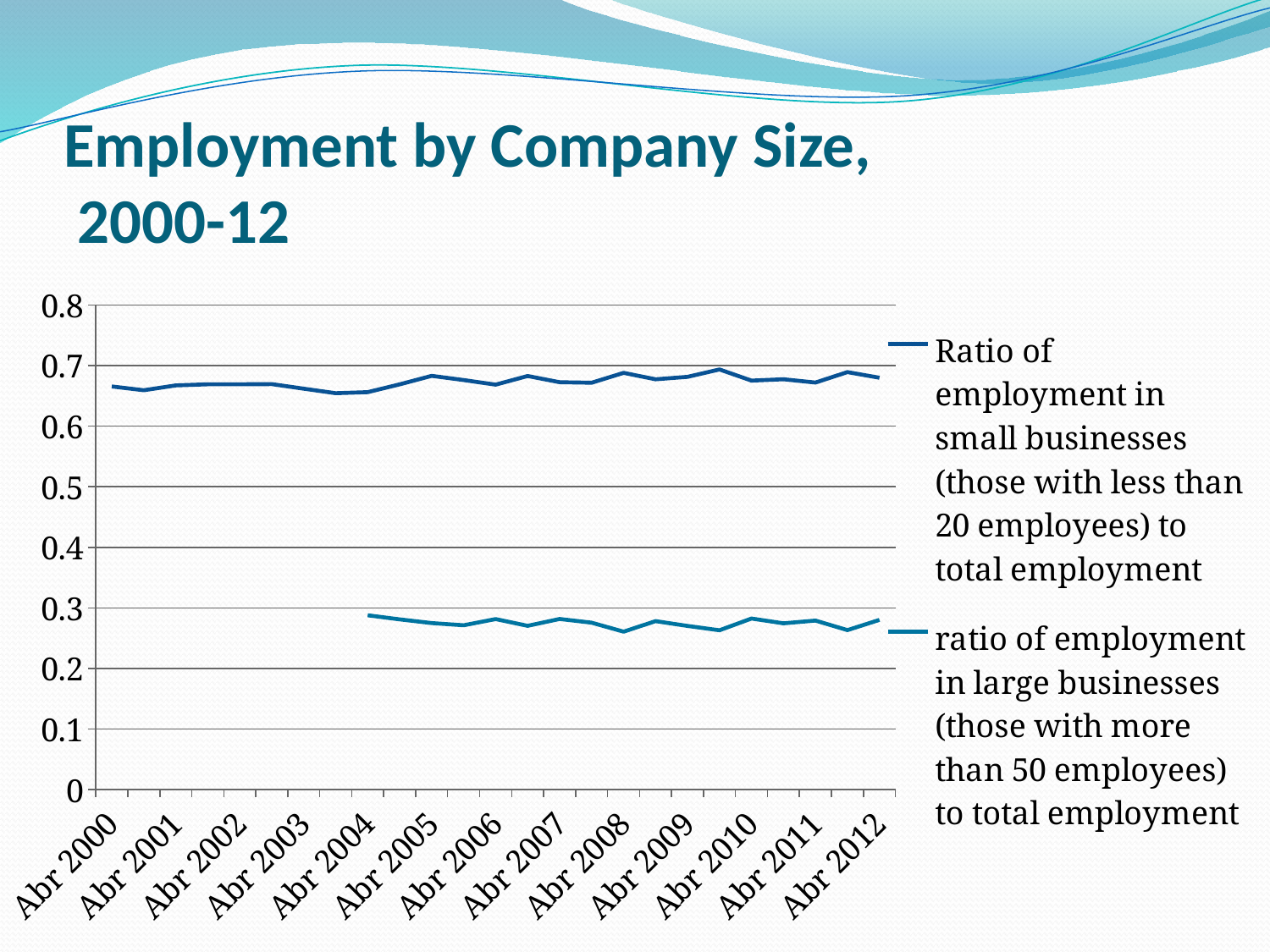
Is the ratio of employment in large businesses at Abr 2008 greater or less than 0.3? less What kind of chart is shown on the slide? Line chart How many year labels are shown on the x axis? 13 At which x-axis label does the large businesses series first appear? Abr 2004 Is the ratio of employment in large businesses at Abr 2004 greater or less than 0.2? greater What is the highest value shown on the y axis? 0.8 Is the ratio of employment in small businesses at Abr 2000 greater or less than 0.6? greater What is the title of the slide's chart? Employment by Company Size, 2000-12 How many series does the legend list? 2 At Abr 2010, which series has the higher value: small businesses or large businesses? Small businesses